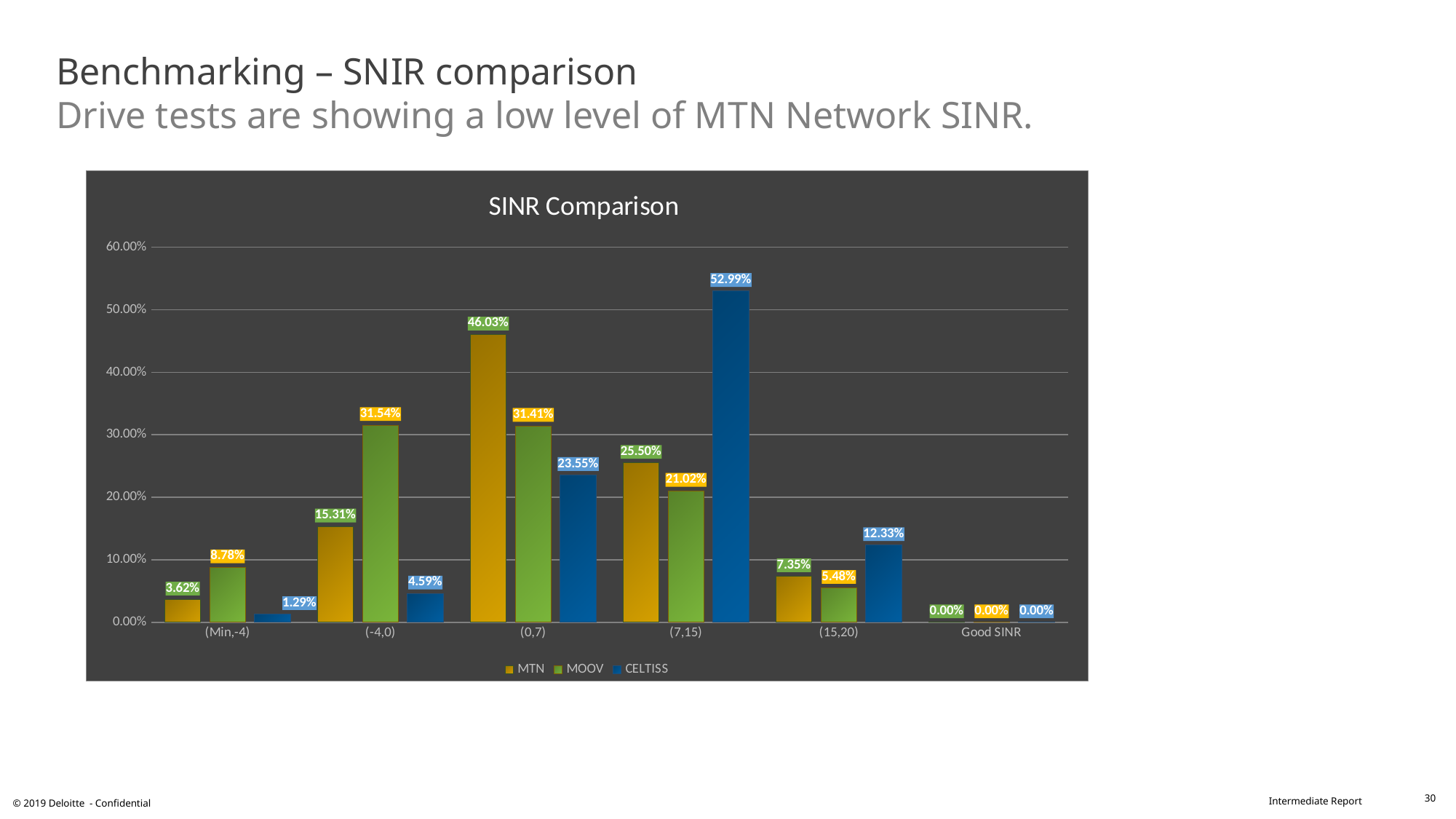
What is the MTN value for the (0,7) category? 46.03% Which series are listed in the legend of the SINR Comparison chart? MTN, MOOV, CELTISS What kind of chart is shown on the slide? Bar chart What is the MOOV value for the (15,20) category? 5.48% What is the CELTISS value for the (7,15) category? 52.99% In which category does MTN have its lowest value? Good SINR How many series does the legend of the SINR Comparison chart list? 3 In which category does CELTISS have its highest value? (7,15) What is the difference between the MTN and MOOV values in the (0,7) category? 14.62% How many categories are shown on the x axis of the SINR Comparison chart? 6 Is the CELTISS value for the (0,7) category greater or less than 20.00%? greater In the (-4,0) category, which is larger, the MTN value or the MOOV value? MOOV